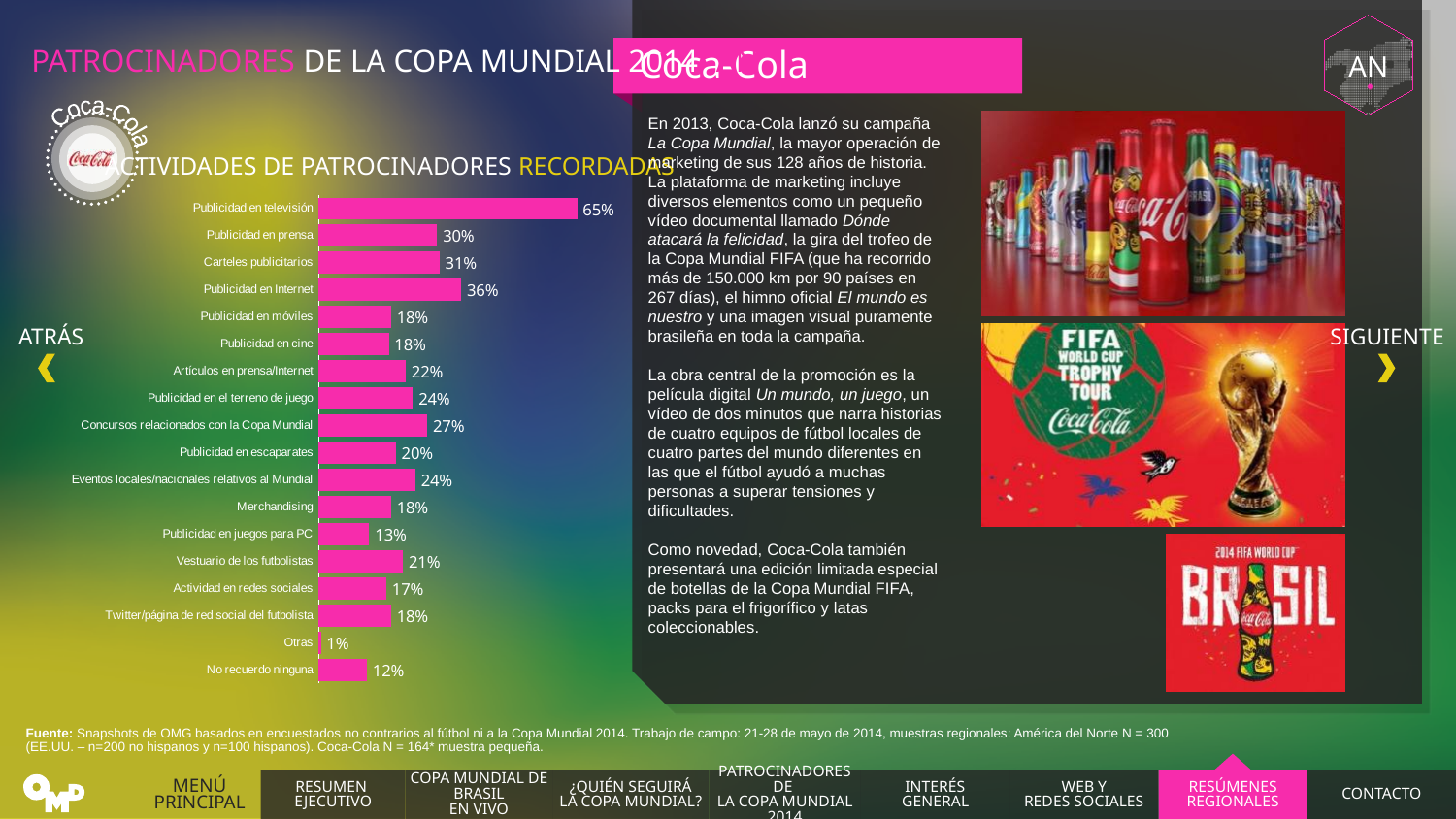
What is the value for Concursos relacionados con la Copa Mundial? 27% Which category has the highest value? Publicidad en televisión What is the value for Publicidad en televisión? 65% What is the value for No recuerdo ninguna? 12% Which category has the lowest value? Otras Which is larger, Carteles publicitarios or Publicidad en prensa? Carteles publicitarios How many categories are shown in the chart? 18 What kind of chart is shown on the slide? Bar chart What is the value for Publicidad en Internet? 36% What is the title of the chart? ACTIVIDADES DE PATROCINADORES RECORDADAS Which is larger, Vestuario de los futbolistas or Actividad en redes sociales? Vestuario de los futbolistas What is the difference between Publicidad en televisión and Publicidad en Internet? 29%